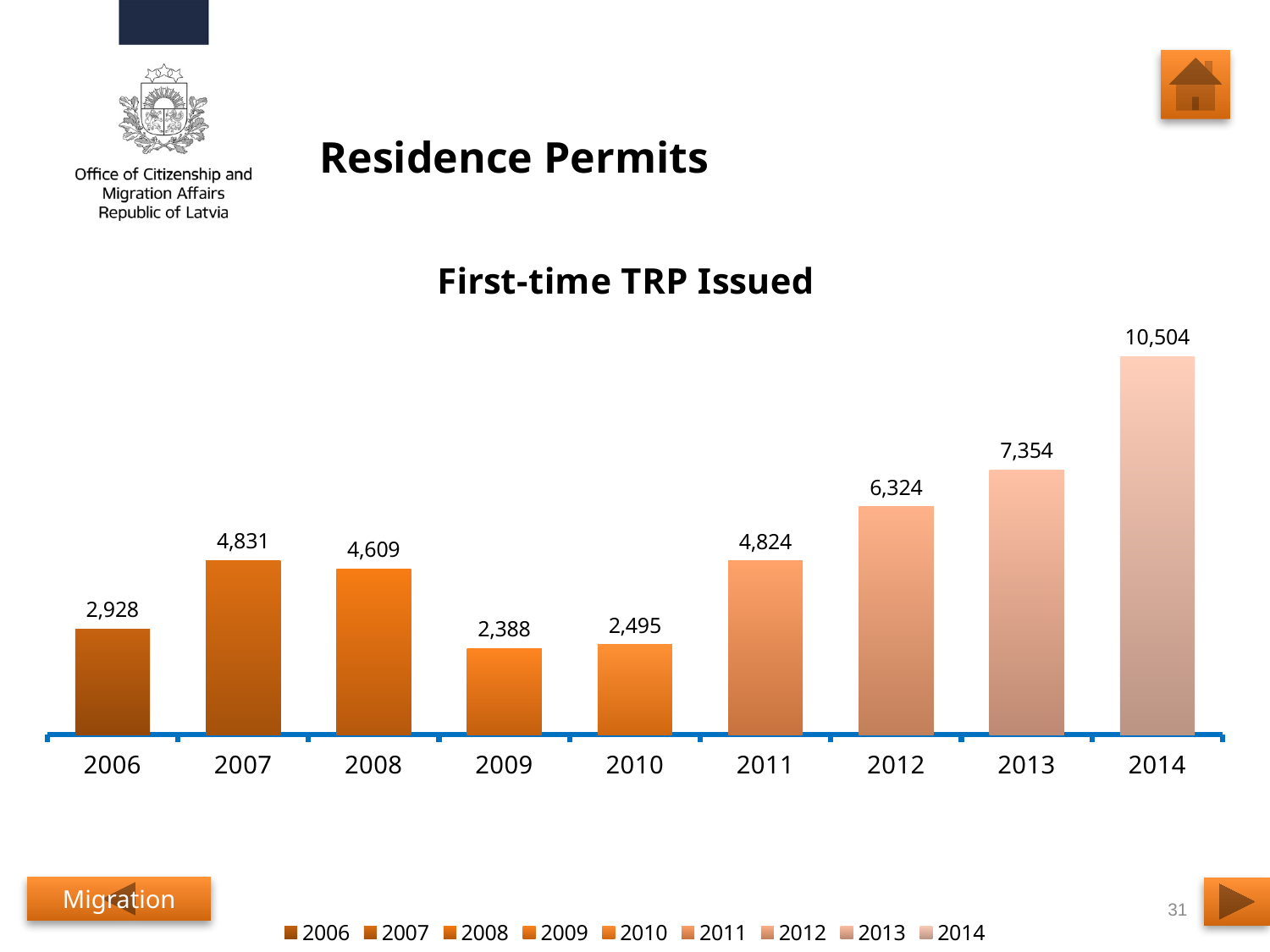
What is the difference between the values for 2007 and 2006 in the First-time TRP Issued chart? 1,903 Which year has the highest value in the First-time TRP Issued chart? 2014 What kind of chart is the First-time TRP Issued chart? bar chart What is the value for 2014 in the First-time TRP Issued chart? 10,504 What is the value for 2009 in the First-time TRP Issued chart? 2,388 Do the values in the First-time TRP Issued chart rise or fall from 2010 to 2014? rise How many entries does the legend of the First-time TRP Issued chart list? 9 What is the value for 2011 in the First-time TRP Issued chart? 4,824 Which year has the lowest value in the First-time TRP Issued chart? 2009 How many years are shown in the First-time TRP Issued chart? 9 Which is larger in the First-time TRP Issued chart, the value for 2012 or the value for 2011? 2012 What is the difference between the values for 2014 and 2013 in the First-time TRP Issued chart? 3,150